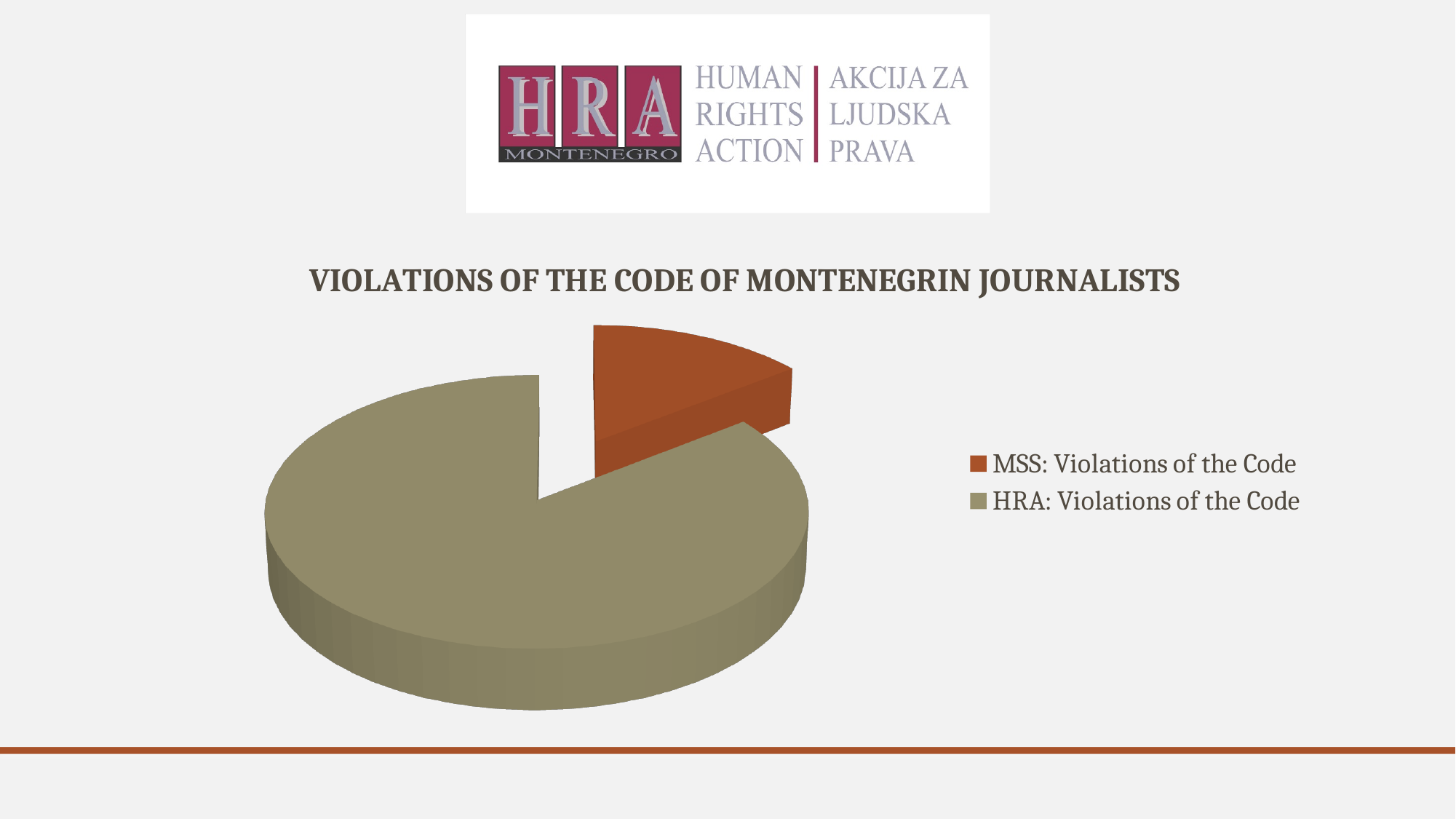
Which slice is the smallest? MSS: Violations of the Code How many entries does the legend list? 2 Which slice is the largest? HRA: Violations of the Code How many slices does the pie chart have? 2 What kind of chart is shown on the slide? pie chart What colour is the slice for MSS: Violations of the Code? orange-brown What is the title of the chart? VIOLATIONS OF THE CODE OF MONTENEGRIN JOURNALISTS Which is larger, the MSS slice or the HRA slice? HRA: Violations of the Code